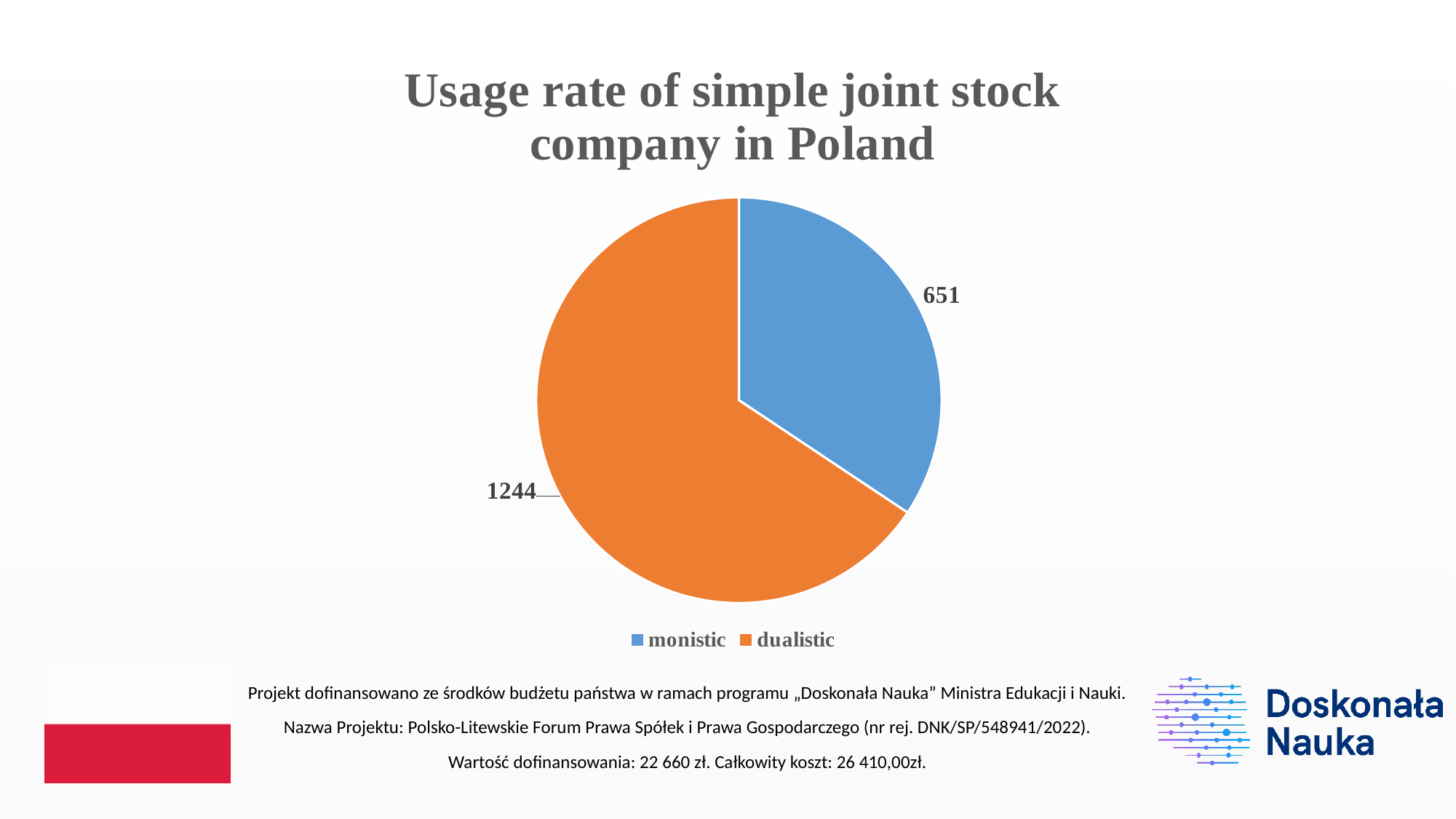
What is the total of the two slices in the pie chart? 1895 What is the difference between the dualistic and monistic values? 593 How many entries does the legend list? 2 What type of chart is shown on the slide? pie chart How many categories does the pie chart show? 2 Which colour represents the dualistic category? orange Which is larger, the monistic value or the dualistic value? dualistic Which category has the largest slice of the pie? dualistic Which category has the smallest slice of the pie? monistic What is the title of the chart? Usage rate of simple joint stock company in Poland What is the value for the dualistic slice? 1244 What is the value for the monistic slice? 651